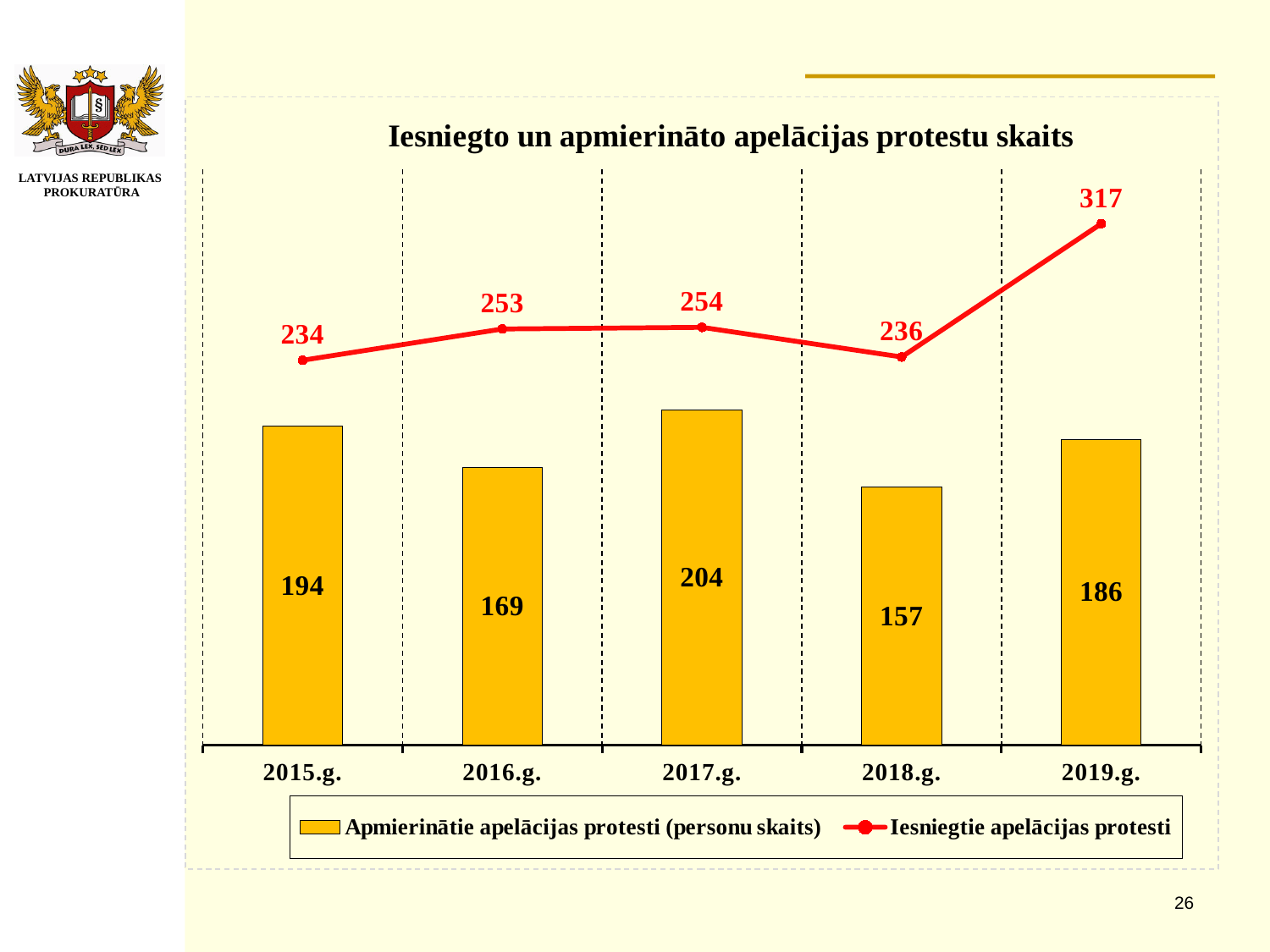
What is the value of Iesniegtie apelācijas protesti for 2015.g.? 234 Which is larger: Apmierinātie apelācijas protesti (personu skaits) in 2015.g. or in 2016.g.? 2015.g. What is the difference between the Apmierinātie apelācijas protesti (personu skaits) values for 2017.g. and 2018.g.? 47 How many years are shown on the x axis? 5 What kind of chart is this? Combined bar and line chart What is the difference between Iesniegtie apelācijas protesti and Apmierinātie apelācijas protesti (personu skaits) in 2019.g.? 131 What is the title of the chart? Iesniegto un apmierināto apelācijas protestu skaits What is the value of Apmierinātie apelācijas protesti (personu skaits) for 2017.g.? 204 What is the value of Iesniegtie apelācijas protesti for 2019.g.? 317 Which year has the highest value for Iesniegtie apelācijas protesti? 2019.g. Which year has the lowest value for Apmierinātie apelācijas protesti (personu skaits)? 2018.g. How many series does the legend list? 2